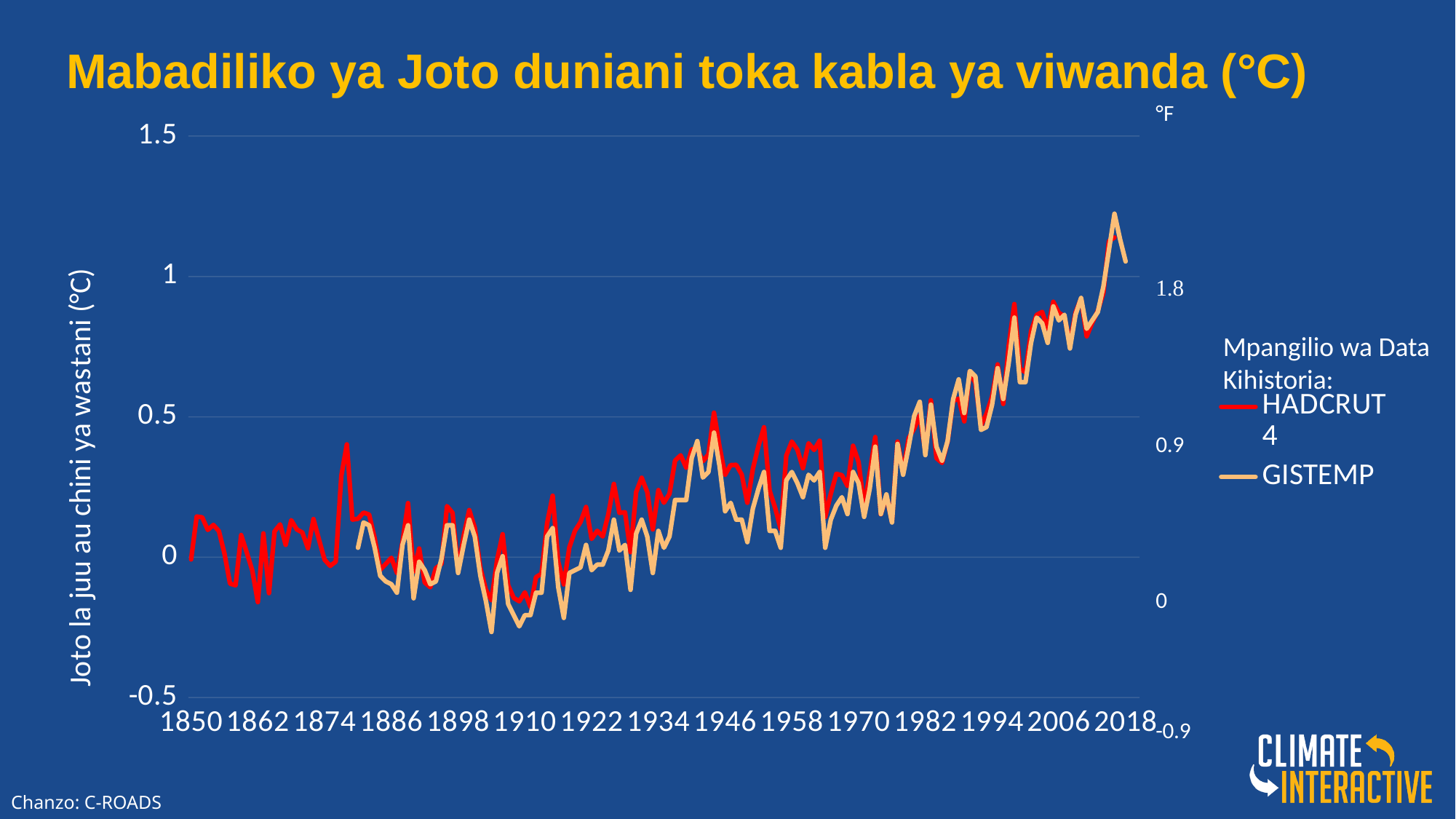
Is the HADCRUT4 value in 1850 greater or less than 0.5? less What is the first year label on the x axis? 1850 Is the GISTEMP value at its peak near 2016 greater or less than 1? greater What is the highest tick value shown on the left y axis? 1.5 Is the HADCRUT4 value around 2006 greater or less than 0.5? greater What kind of chart is shown on the slide? Line chart Overall, do the temperature values rise or fall from 1850 to 2018? Rise How many year labels are shown along the x axis? 15 Which colour is used for the GISTEMP line? Orange (tan) How many data series does the legend list? 2 What are the names of the two series in the legend? HADCRUT4 and GISTEMP